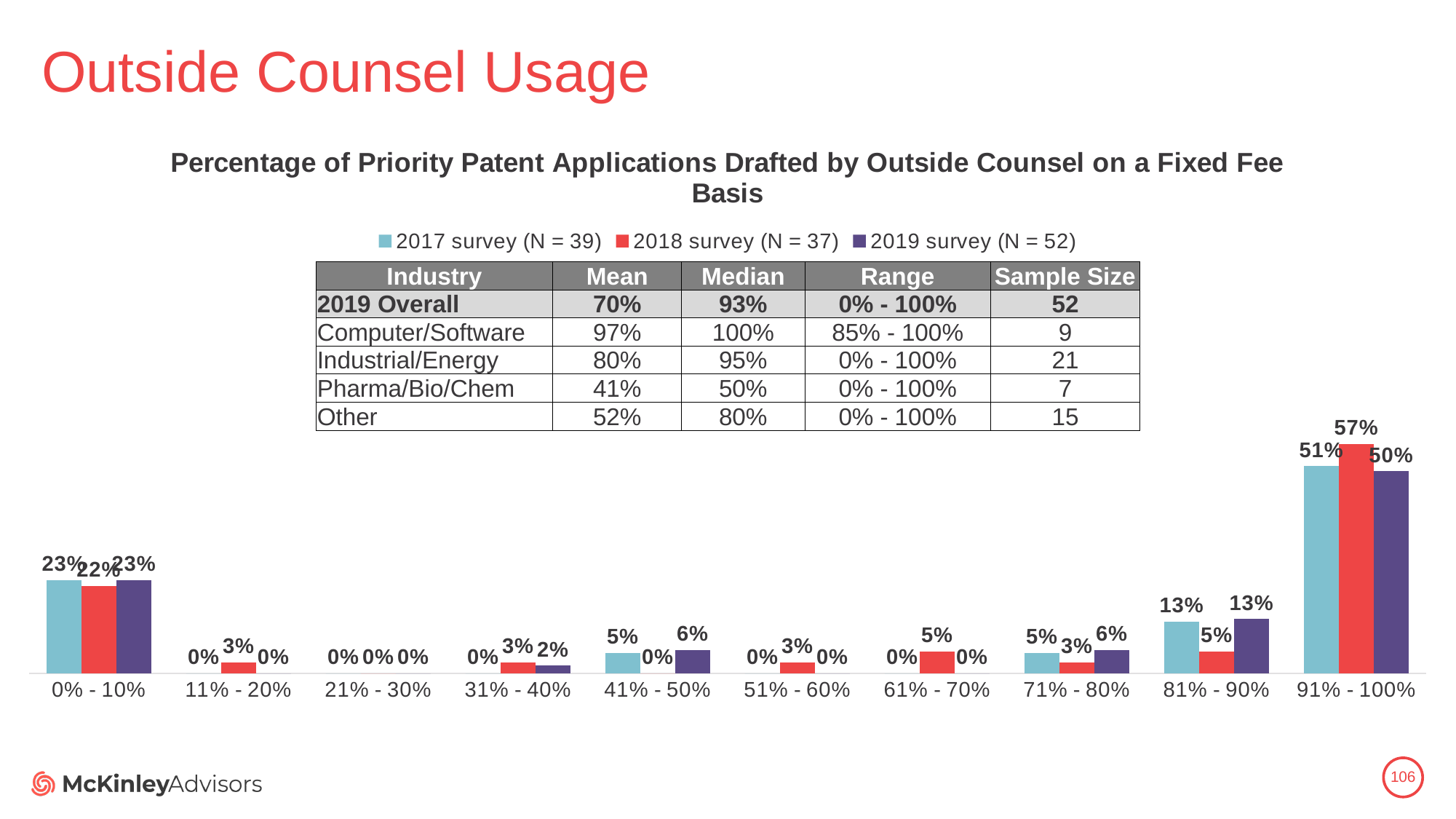
What is the difference between the 2017 survey and the 2018 survey values in the 81% - 90% category? 8% What kind of chart is shown on the slide? Bar chart What is the value for the 2018 survey in the 91% - 100% category? 57% Which is larger in the 41% - 50% category: the 2017 survey value or the 2019 survey value? 2019 survey What is the difference between the 2018 survey and the 2019 survey values in the 91% - 100% category? 7% What is the value for the 2019 survey in the 0% - 10% category? 23% How many series does the chart legend list? 3 What is the value for the 2018 survey in the 61% - 70% category? 5% What is the value for the 2017 survey in the 81% - 90% category? 13% Which category has the highest value for the 2019 survey? 91% - 100% What is the sample size (N) for the 2019 survey according to the legend? 52 How many categories are shown on the x axis of the chart? 10